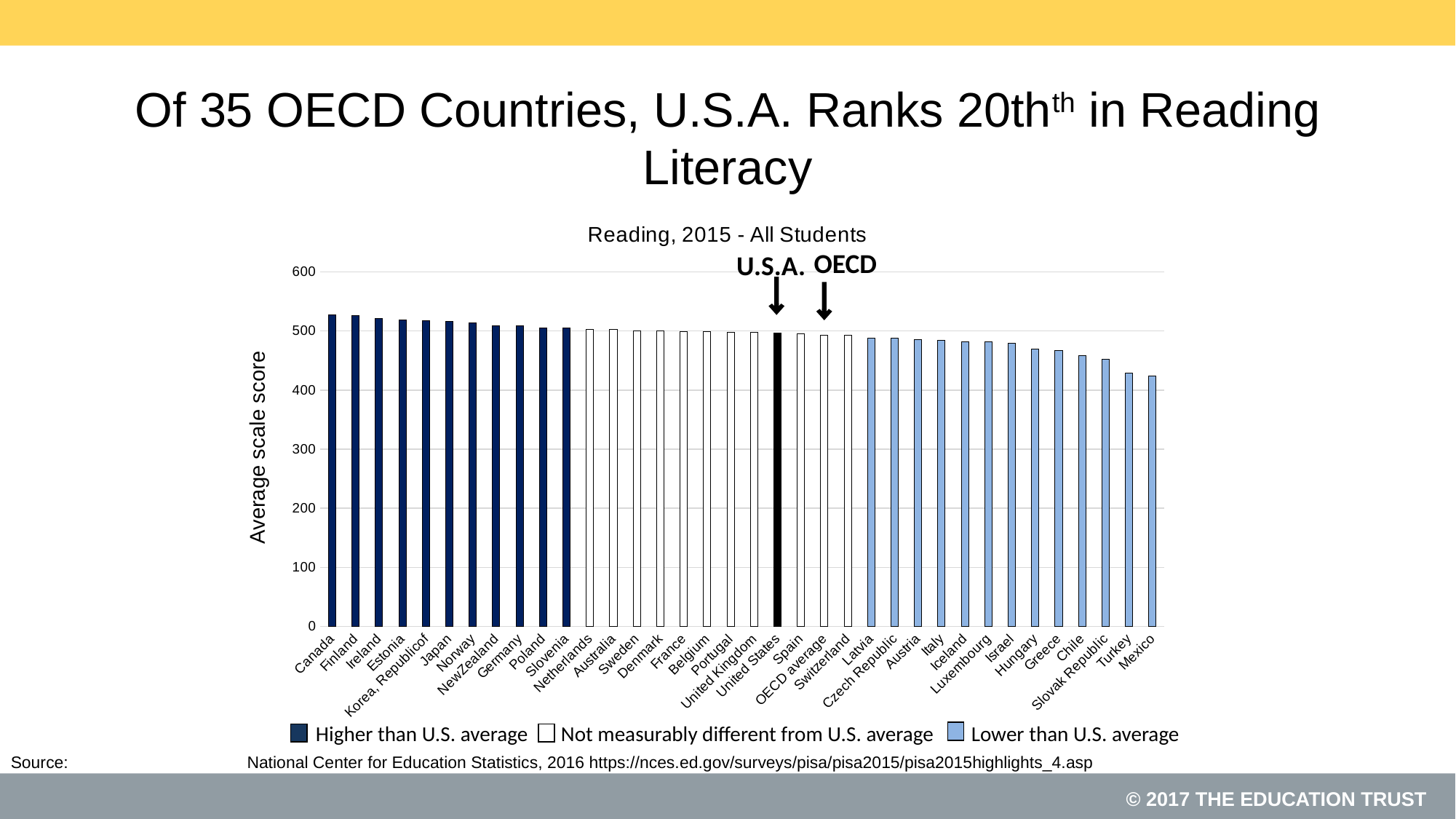
How many bars are plotted in the chart? 36 Is the value for Mexico greater or less than 400? greater What kind of chart is shown on the slide? bar chart Is the value for Turkey greater or less than 500? less Do the values rise or fall moving from left to right along the x axis? fall How many entries does the chart's legend list? 3 Which has a higher average scale score, Japan or Turkey? Japan Is the value for Canada greater or less than 500? greater What is the title of the chart? Reading, 2015 - All Students Which has a higher average scale score, Canada or Mexico? Canada Which category has the lowest average scale score? Mexico